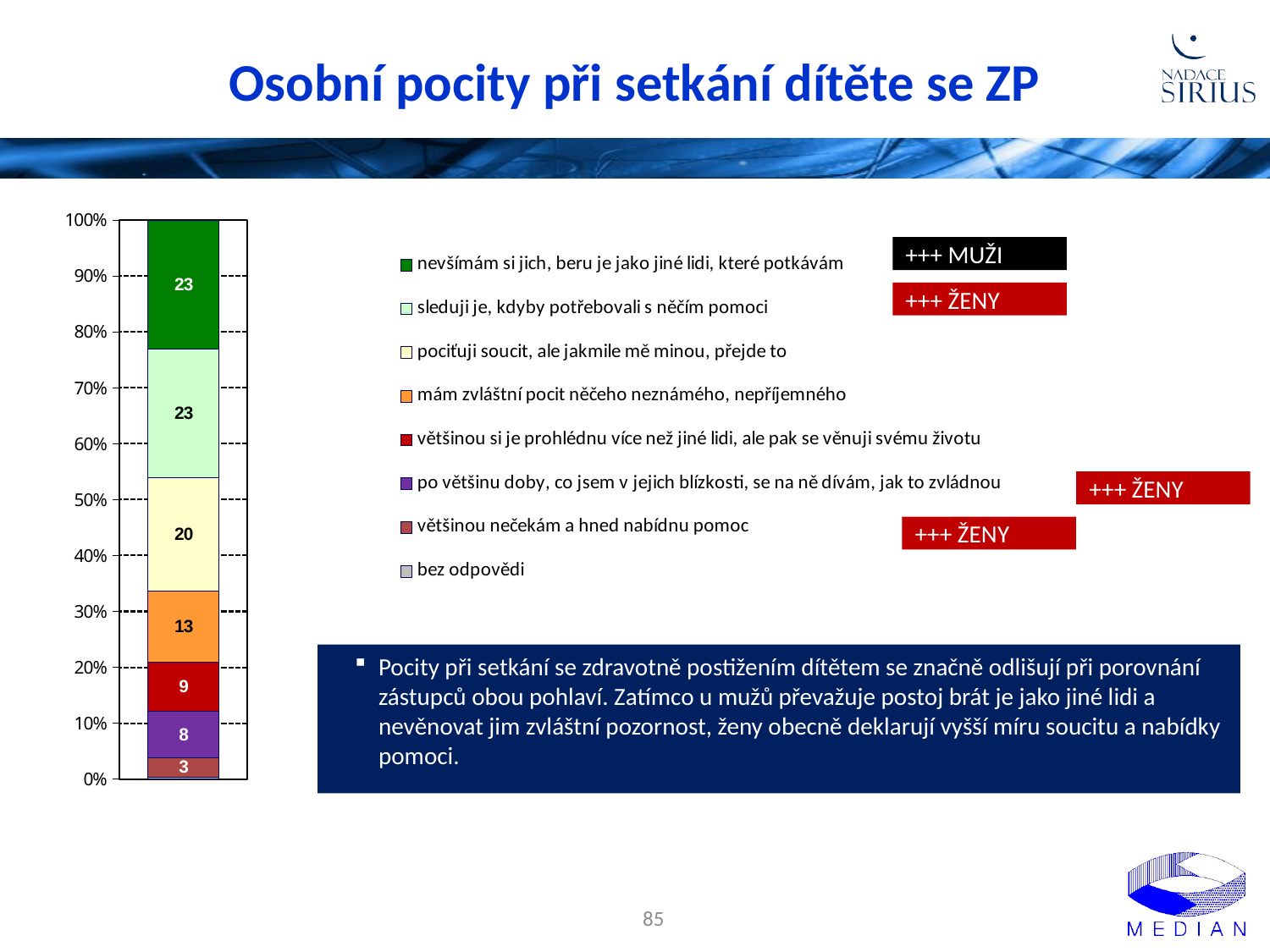
What value is shown for the segment "většinou nečekám a hned nabídnu pomoc"? 3 What value is shown for the segment "pociťuji soucit, ale jakmile mě minou, přejde to"? 20 What value is shown for the segment "většinou si je prohlédnu více než jiné lidi, ale pak se věnuji svému životu"? 9 What is the title of the slide containing the chart? Osobní pocity při setkání dítěte se ZP What kind of chart is shown on the slide? stacked bar chart What value is shown for the segment "mám zvláštní pocit něčeho neznámého, nepříjemného"? 13 How many entries does the chart legend list? 8 What is the difference between the value for "pociťuji soucit, ale jakmile mě minou, přejde to" and the value for "mám zvláštní pocit něčeho neznámého, nepříjemného"? 7 What is the difference between the value for "většinou si je prohlédnu více než jiné lidi, ale pak se věnuji svému životu" and the value for "po většinu doby, co jsem v jejich blízkosti, se na ně dívám, jak to zvládnou"? 1 What value is shown for the segment "po většinu doby, co jsem v jejich blízkosti, se na ně dívám, jak to zvládnou"? 8 What value is shown for the segment "sleduji je, kdyby potřebovali s něčím pomoci"? 23 Which is larger: the value for "pociťuji soucit, ale jakmile mě minou, přejde to" or for "mám zvláštní pocit něčeho neznámého, nepříjemného"? pociťuji soucit, ale jakmile mě minou, přejde to